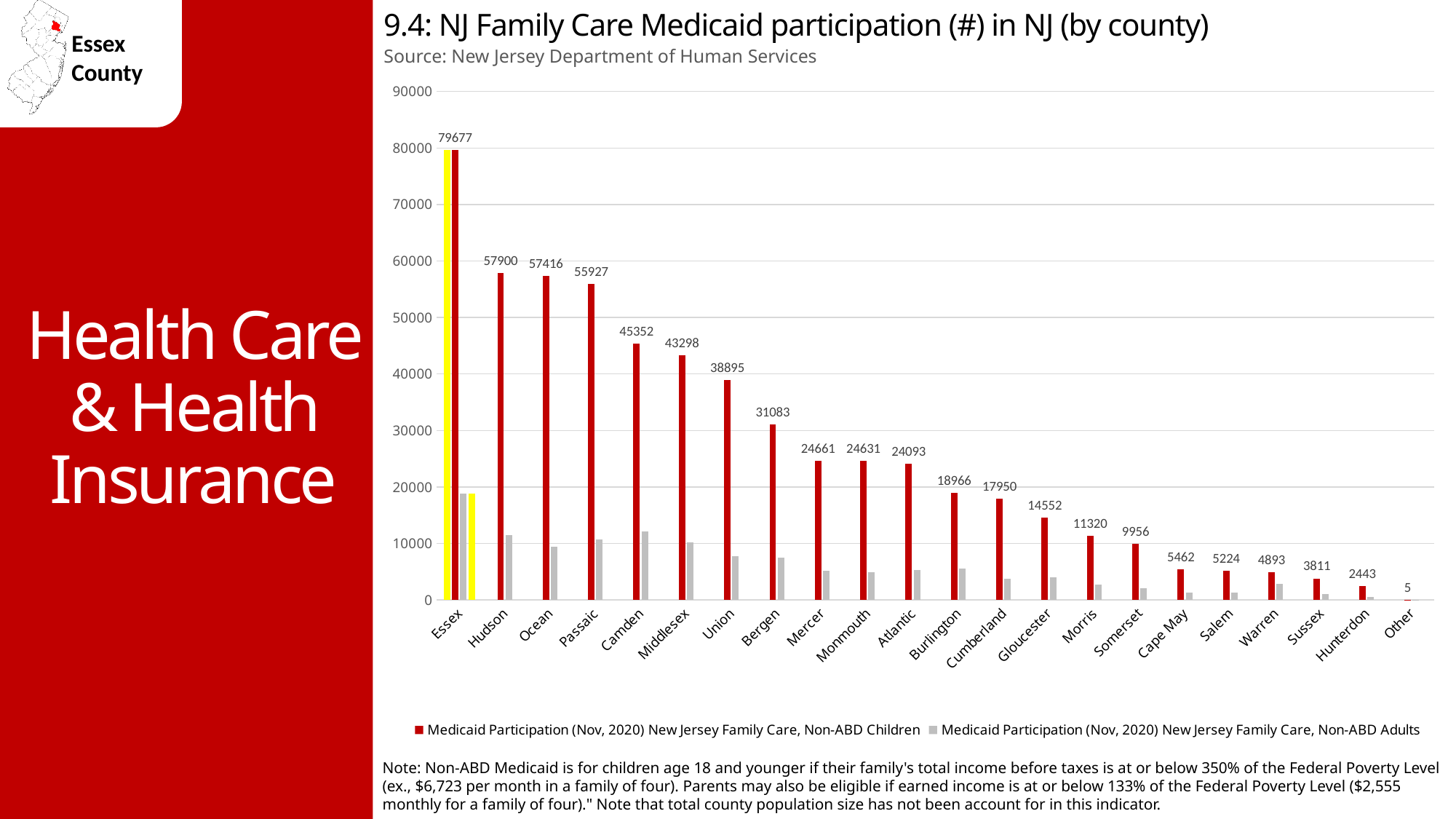
Which has a larger Non-ABD Children value, Union or Bergen? Union Is the Non-ABD Adults value for Essex greater or less than 10000? greater What is the difference between the Non-ABD Children values for Hudson and Ocean? 484 Which county has the highest Non-ABD Children Medicaid participation? Essex Do the Non-ABD Children values rise or fall from Essex to Other along the x axis? fall How many categories are shown on the x axis? 22 How many series does the legend list? 2 What is the Non-ABD Children Medicaid participation value for Camden? 45352 What is the Non-ABD Children Medicaid participation value for Essex? 79677 Which category has the lowest Non-ABD Children Medicaid participation? Other What kind of chart is shown on the slide? bar chart What is the Non-ABD Children Medicaid participation value for Cape May? 5462